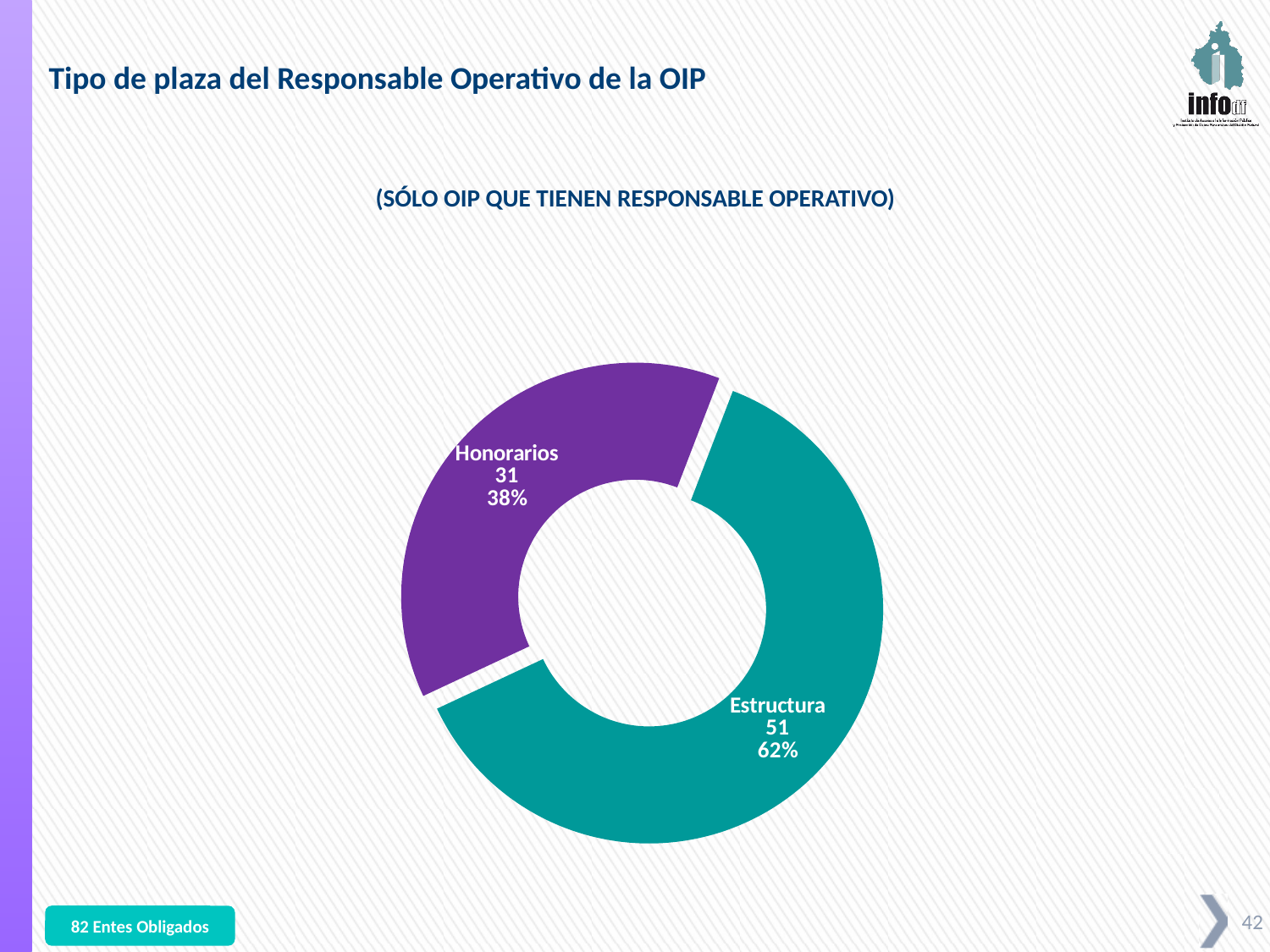
What kind of chart is shown on the slide? Doughnut (pie) chart Which category has the smallest share? Honorarios What colour is the Honorarios slice? Purple How many categories does the chart show? 2 What is the value for Estructura? 51 What is the value for Honorarios? 31 What percentage share does Honorarios have? 38% What is the difference between the values for Estructura and Honorarios? 20 What is the total of the two categories shown in the chart? 82 What percentage share does Estructura have? 62% Which is larger, Estructura or Honorarios? Estructura Which category has the largest share? Estructura